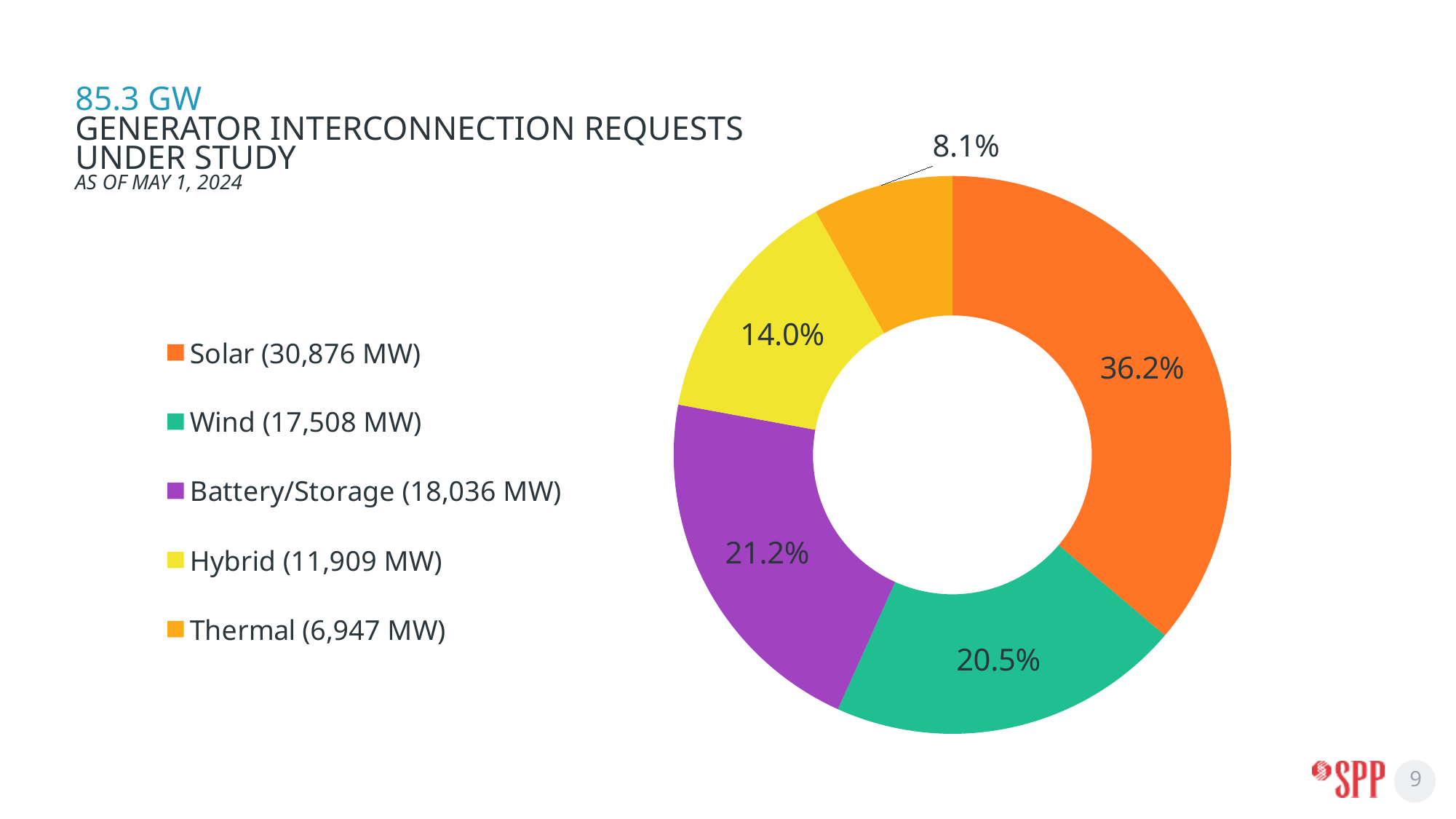
What is the MW value shown for Battery/Storage in the legend? 18,036 MW What is the difference in percentage points between the Solar share and the Wind share? 15.7% What total capacity is stated above the chart title? 85.3 GW What share of the pie does Thermal represent? 8.1% What is the difference in MW between Solar and Hybrid according to the legend? 18,967 MW Which has the larger share, Battery/Storage or Wind? Battery/Storage How many categories does the pie chart show? 5 Which category has the largest share of the pie? Solar Which category has the smallest share of the pie? Thermal What kind of chart is shown on the slide? Pie chart (donut) What is the MW value shown for Wind in the legend? 17,508 MW What share of the pie does Solar represent? 36.2%